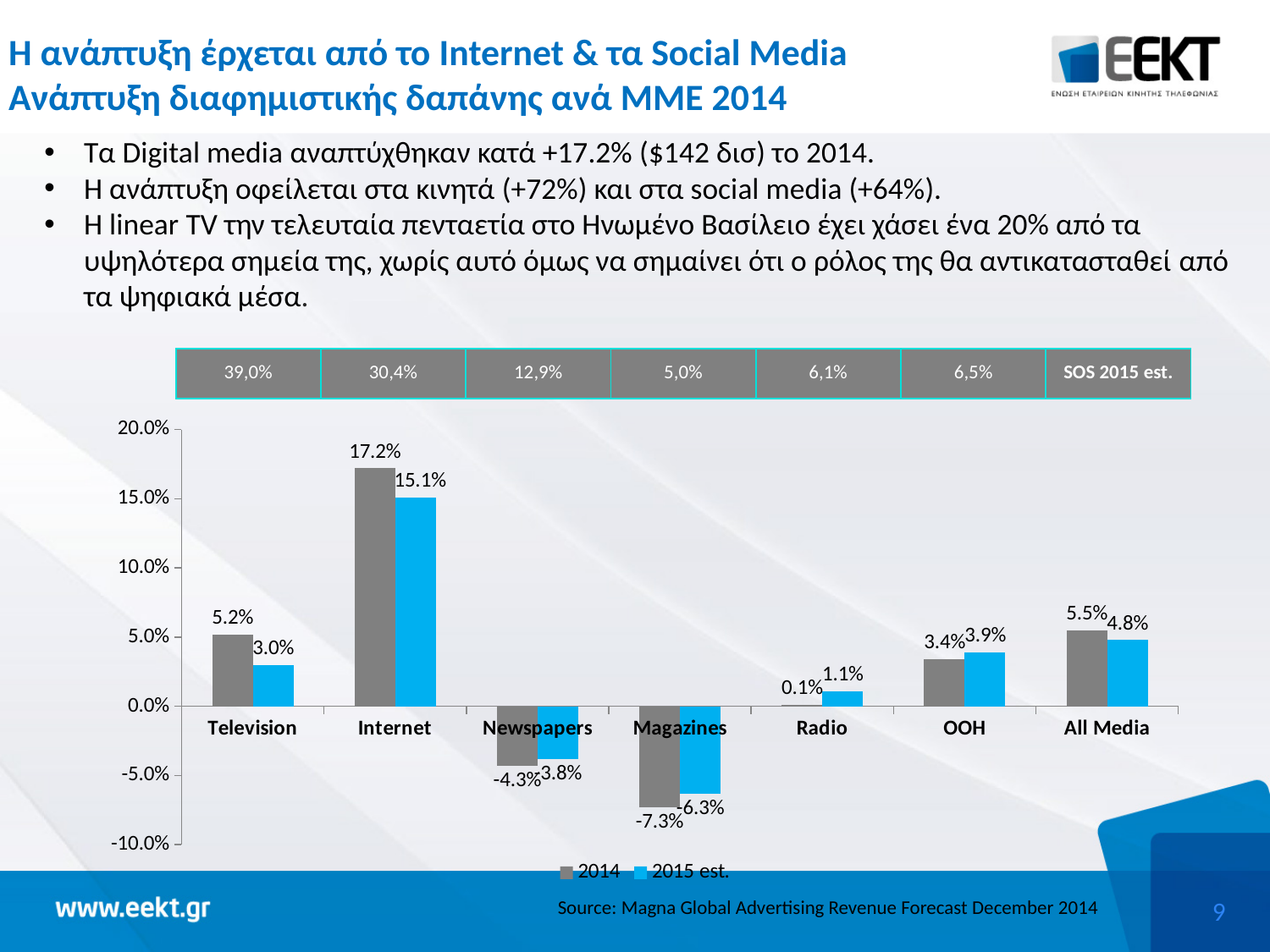
What is the difference between the 2014 and 2015 est. values for Internet? 2.1% Which category has the lowest 2014 value in the chart? Magazines Which series is shown in blue in the chart? 2015 est. What is the 2015 est. value for Television in the chart? 3.0% Which category has the highest 2014 value in the chart? Internet How many series does the chart legend list? 2 What is the 2014 value for Internet in the chart? 17.2% What is the 2015 est. value for OOH in the chart? 3.9% Which is larger for All Media: the 2014 value or the 2015 est. value? 2014 How many media categories are shown on the x axis of the chart? 7 What is the 2014 value for Radio in the chart? 0.1% What kind of chart is shown on the slide? bar chart